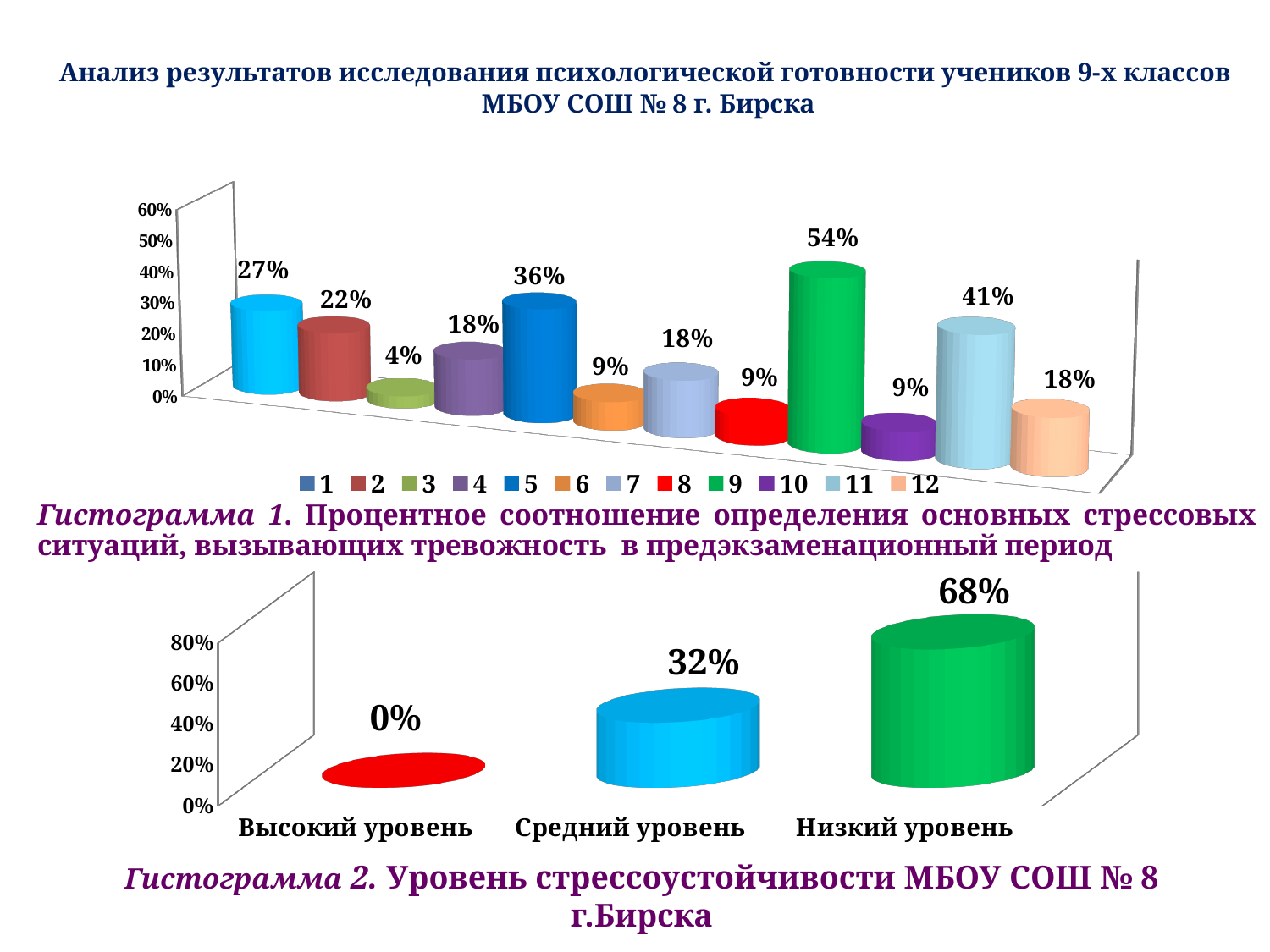
In the top chart (Гистограмма 1), what is the difference between the values for series 9 and series 11? 13% In the bottom chart (Гистограмма 2), what is the value for Высокий уровень? 0% In the bottom chart (Гистограмма 2), what is the difference between Низкий уровень and Средний уровень? 36% In the top chart (Гистограмма 1), what is the value for series 9? 54% In the bottom chart (Гистограмма 2), what is the value for Средний уровень? 32% What kind of chart is the bottom chart (Гистограмма 2)? Bar chart In the bottom chart (Гистограмма 2), which category has the highest value? Низкий уровень In the top chart (Гистограмма 1), which series has the lowest value? 3 In the top chart (Гистограмма 1), what is the value for series 3? 4% In the top chart (Гистограмма 1), which is larger, the value for series 1 or series 5? 5 In the top chart (Гистограмма 1), which series has the highest value? 9 How many series does the legend of the top chart (Гистограмма 1) list? 12